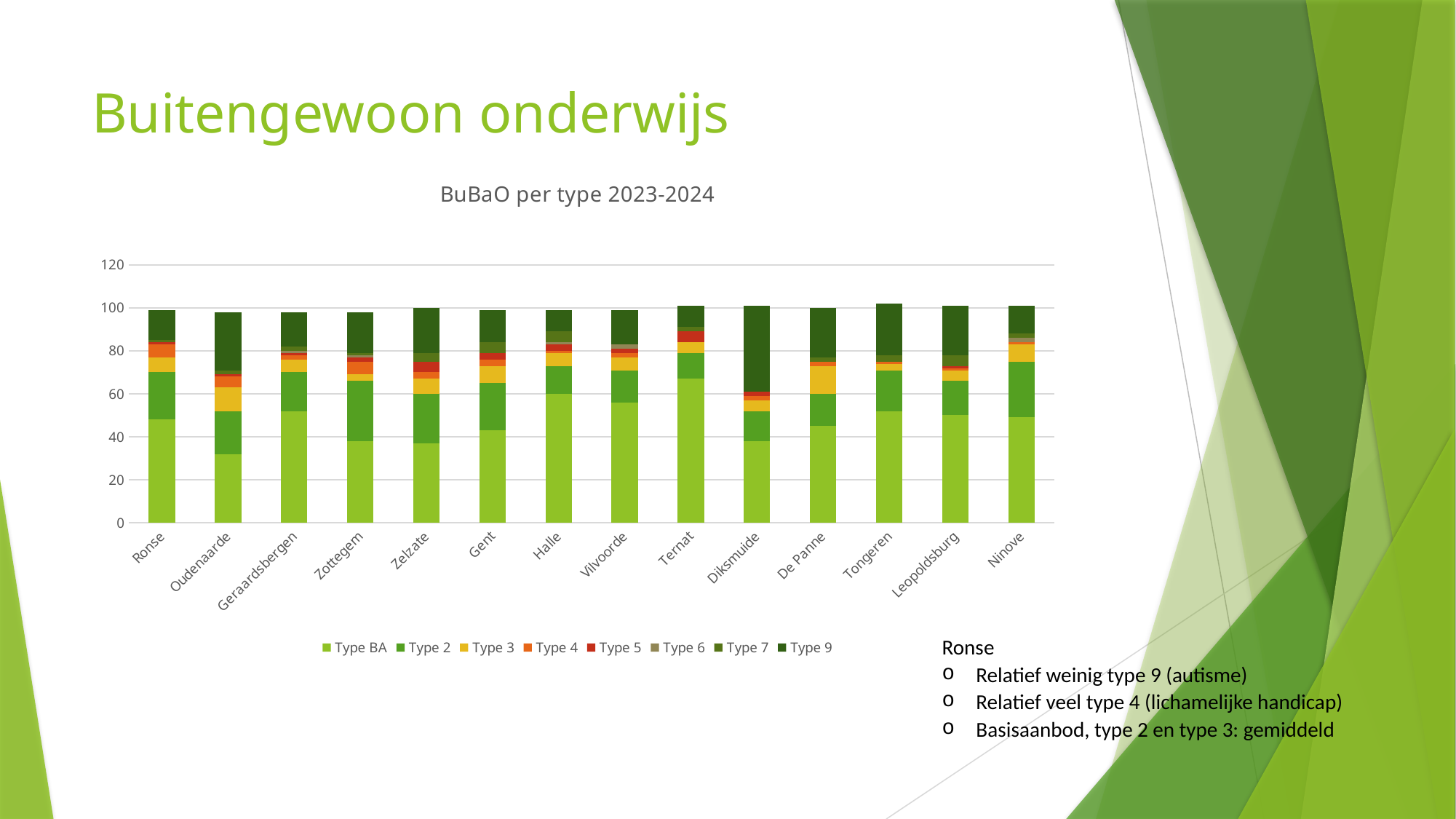
Which has the larger Type 9 segment, Diksmuide or Ronse? Diksmuide Is the Type BA value for Ternat greater or less than 60? greater How many categories (municipalities) are shown on the x axis of the chart? 14 What is the title of the chart? BuBaO per type 2023-2024 Which series is listed first in the chart legend? Type BA Is the Type BA value for Oudenaarde greater or less than 40? less How many series does the chart legend list? 8 Which municipality has the highest Type BA value? Ternat Is the Type BA value for Ronse greater or less than 60? less Which municipality has the lowest Type BA value? Oudenaarde What kind of chart is shown on the slide? Stacked bar chart